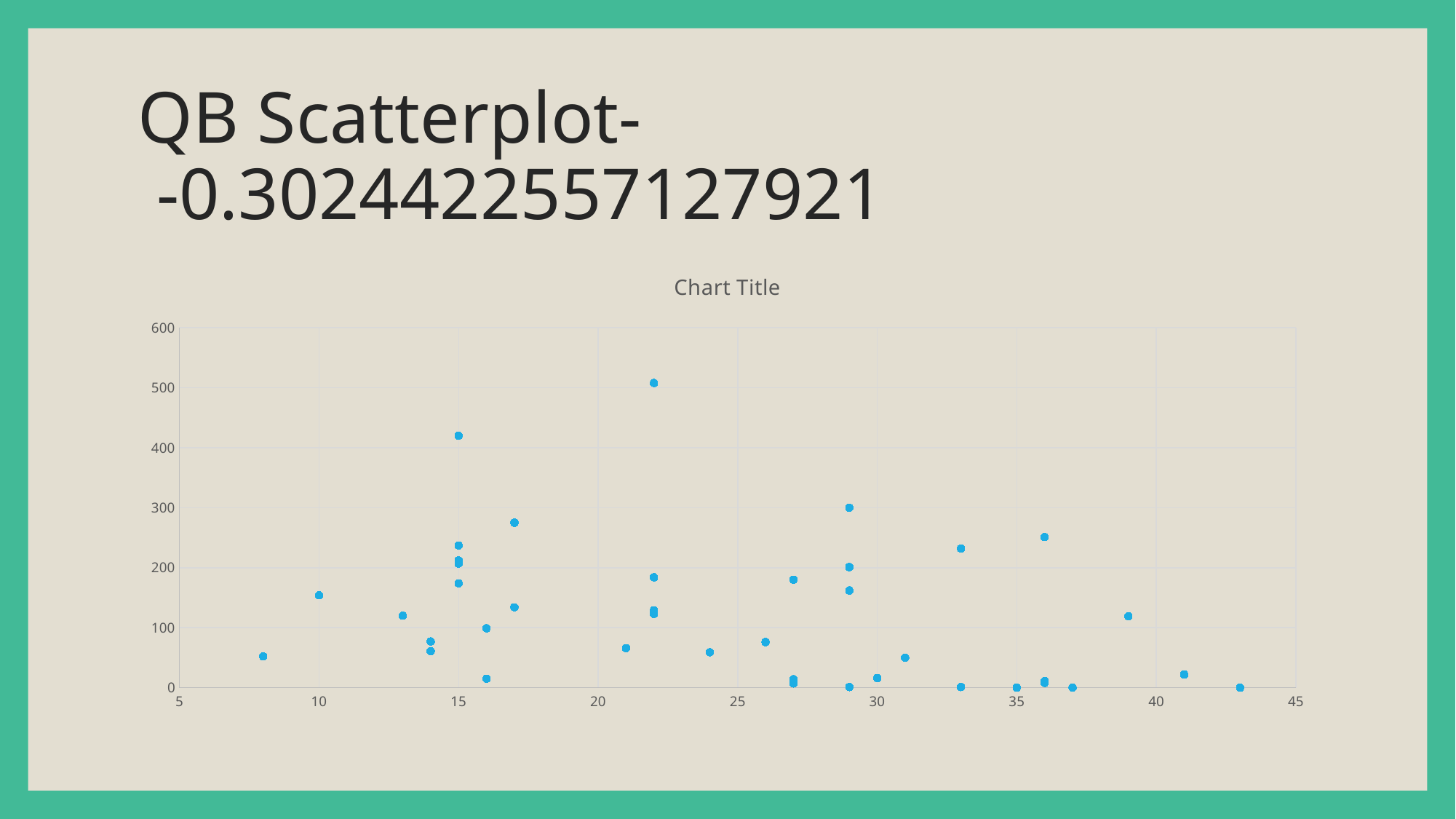
Is the y value of the highest point at x = 17 greater or less than 200? greater What is the title printed above the chart? Chart Title Is the y value of the point at x = 10 greater or less than 200? less Is the y value of the highest point on the chart greater or less than 400? greater Which has the larger y value: the highest point at x = 15 or the highest point at x = 30? the highest point at x = 15 What is the maximum value shown on the vertical axis? 600 What kind of chart is shown on the slide? scatter plot